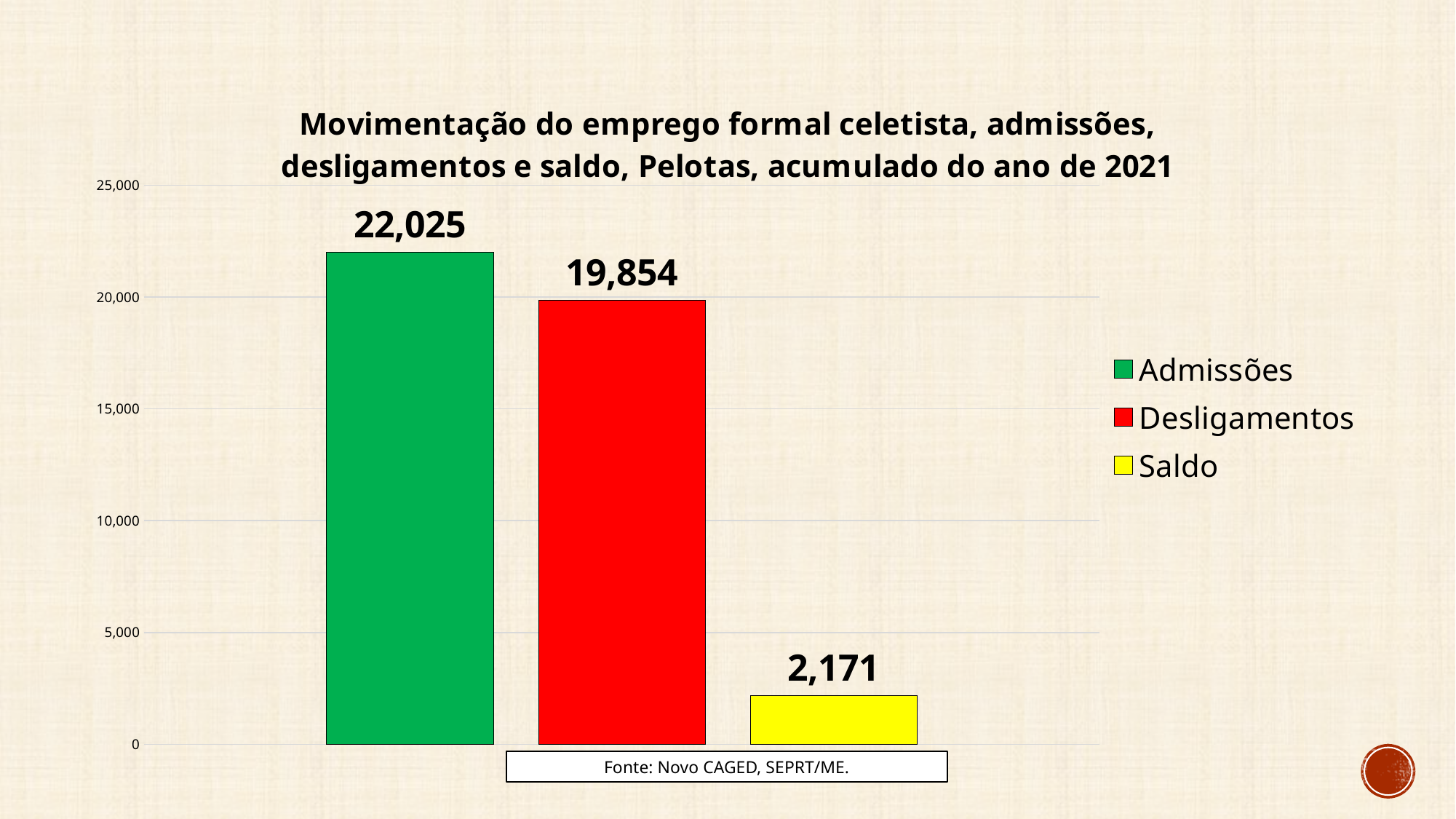
What is the value for Desligamentos? 19,854 Which series has the lowest value? Saldo Which series has the highest value? Admissões What is the value for Admissões? 22,025 How many bars are plotted in the chart? 3 How many series does the legend list? 3 What is the value for Saldo? 2,171 What colour is the bar for Saldo? yellow Which is larger, Desligamentos or Saldo? Desligamentos Is the value for Desligamentos greater or less than 20,000? less What kind of chart is shown on the slide? bar chart What is the difference between Admissões and Desligamentos? 2,171